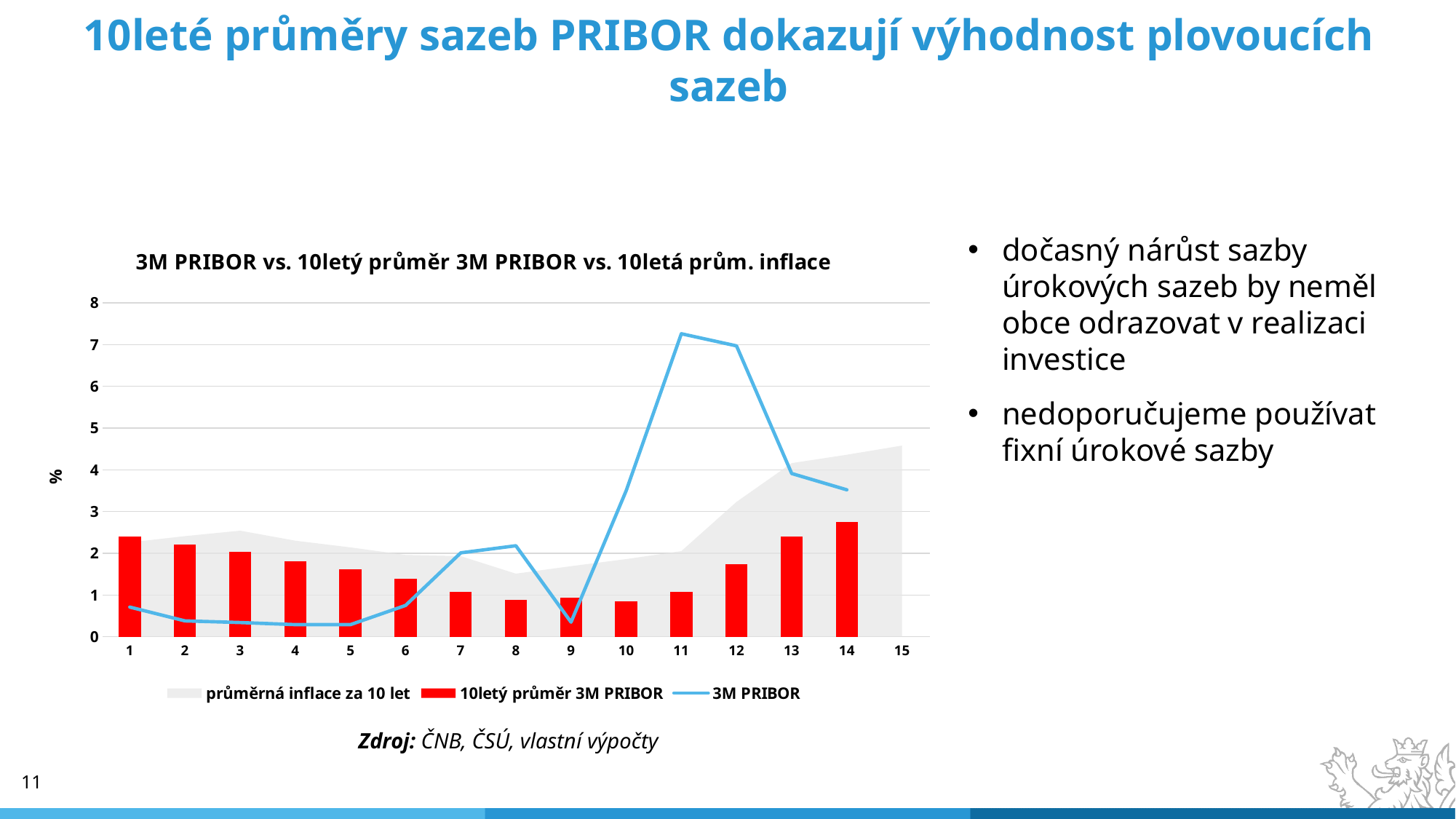
Is the value of 10letý průměr 3M PRIBOR at category 14 greater or less than 2? greater What is the title of the chart? 3M PRIBOR vs. 10letý průměr 3M PRIBOR vs. 10letá prům. inflace Which series is drawn as red bars? 10letý průměr 3M PRIBOR Is the value of 3M PRIBOR at category 11 greater or less than 7? greater How many bars for 10letý průměr 3M PRIBOR are plotted on the chart? 14 Which has the larger 10letý průměr 3M PRIBOR bar, category 2 or category 5? Category 2 At which x-axis category does the 3M PRIBOR line reach its highest value? 11 How many series does the chart legend list? 3 Do the 10letý průměr 3M PRIBOR bars rise or fall from category 1 to category 6? fall Is the value of 3M PRIBOR at category 9 greater or less than 1? less What kind of chart is shown on the slide? A combination chart with an area, bars and a line Which category has the tallest bar for 10letý průměr 3M PRIBOR? 14